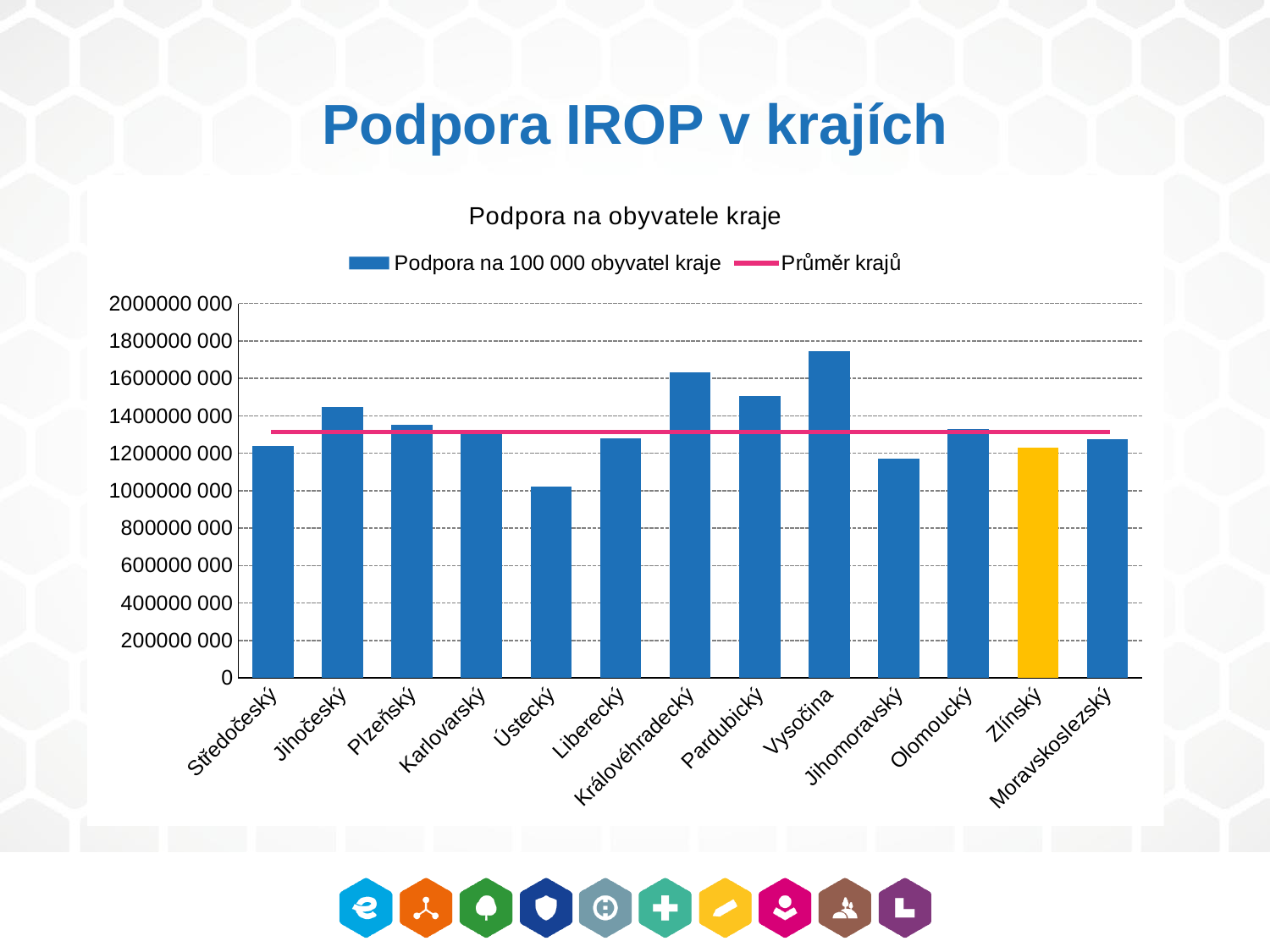
Which has a larger value, Královéhradecký or Vysočina? Vysočina Is the value for Vysočina greater or less than 1600000 000? greater Is the value for Jihomoravský greater or less than 1200000 000? less How many regions (categories) are shown on the x axis of the chart? 13 Which has a larger value, Středočeský or Jihočeský? Jihočeský Which region has the highest value for Podpora na 100 000 obyvatel kraje? Vysočina How many series does the chart legend list? 2 Which region has the lowest value for Podpora na 100 000 obyvatel kraje? Ústecký Is the value for Ústecký greater or less than 1200000 000? less What kind of chart is shown on the slide? combination bar and line chart Which region's bar is shown in a different colour (yellow) from the other bars? Zlínský